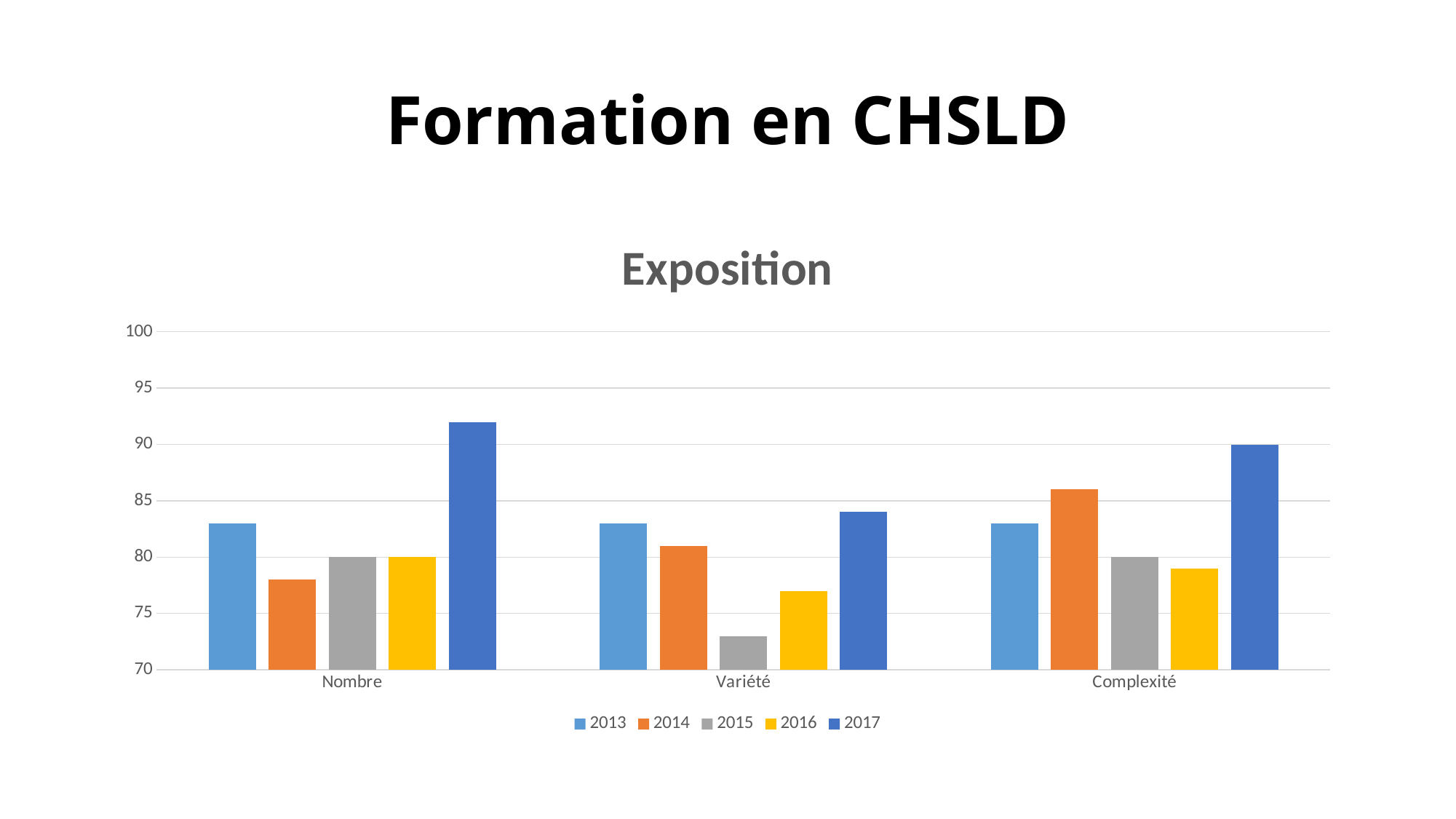
What is the title of the chart? Exposition What is the value for 2015 in the Nombre category? 80 How many series does the legend list? 5 What type of chart is shown on the slide? bar chart How many categories are shown on the x axis? 3 Which series has the highest value in the Nombre category? 2017 Is the value for 2017 in the Nombre category greater or less than 90? greater Which series has the lowest value in the Variété category? 2015 What is the value for 2015 in the Complexité category? 80 Is the value for 2015 in the Variété category greater or less than 75? less What is the value for 2017 in the Complexité category? 90 Which is larger in the Complexité category, the value for 2014 or the value for 2013? 2014